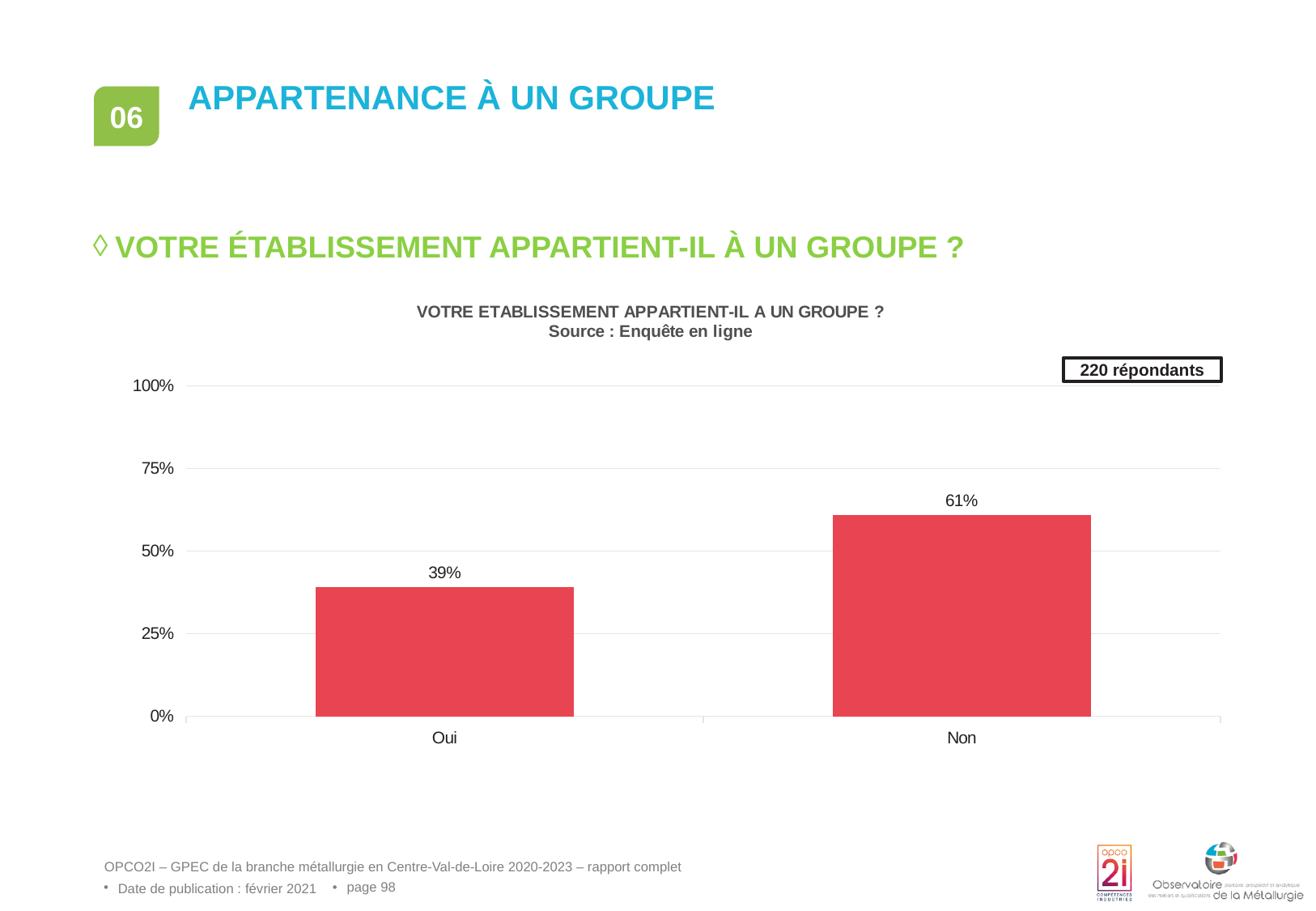
Which category has the highest value? Non What is the value for Oui? 39% Which category has the lowest value? Oui Is the value for Oui greater or less than 50%? less How many categories are shown on the x axis? 2 What is the value for Non? 61% What is the difference between the values for Non and Oui? 22% How many respondents does the chart report? 220 répondants Is the value for Non greater or less than 50%? greater What is the source given under the chart title? Enquête en ligne What kind of chart is shown? bar chart Which is larger, the value for Oui or the value for Non? Non